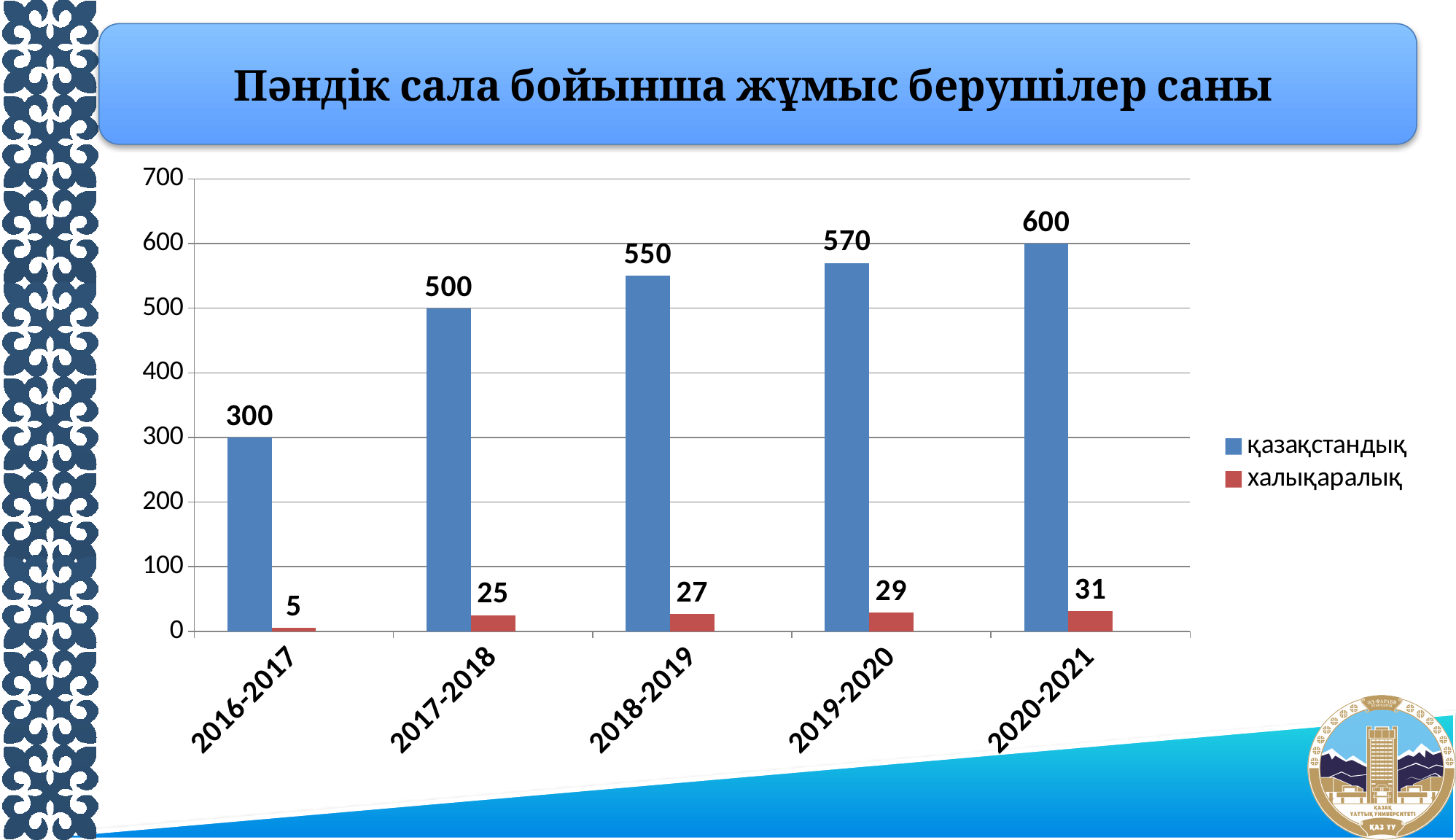
What is the value for халықаралық in 2016-2017? 5 Do the қазақстандық values rise or fall from 2016-2017 to 2020-2021? rise Which year has the lowest value for халықаралық? 2016-2017 How many series does the legend list? 2 Which year has the highest value for қазақстандық? 2020-2021 What is the difference between the қазақстандық values for 2017-2018 and 2016-2017? 200 What kind of chart is shown on the slide? bar chart Is the value for қазақстандық in 2019-2020 greater or less than 500? greater Which is larger: the халықаралық value for 2019-2020 or for 2018-2019? 2019-2020 How many year categories are shown on the x axis? 5 What is the value for қазақстандық in 2018-2019? 550 What is the value for халықаралық in 2020-2021? 31